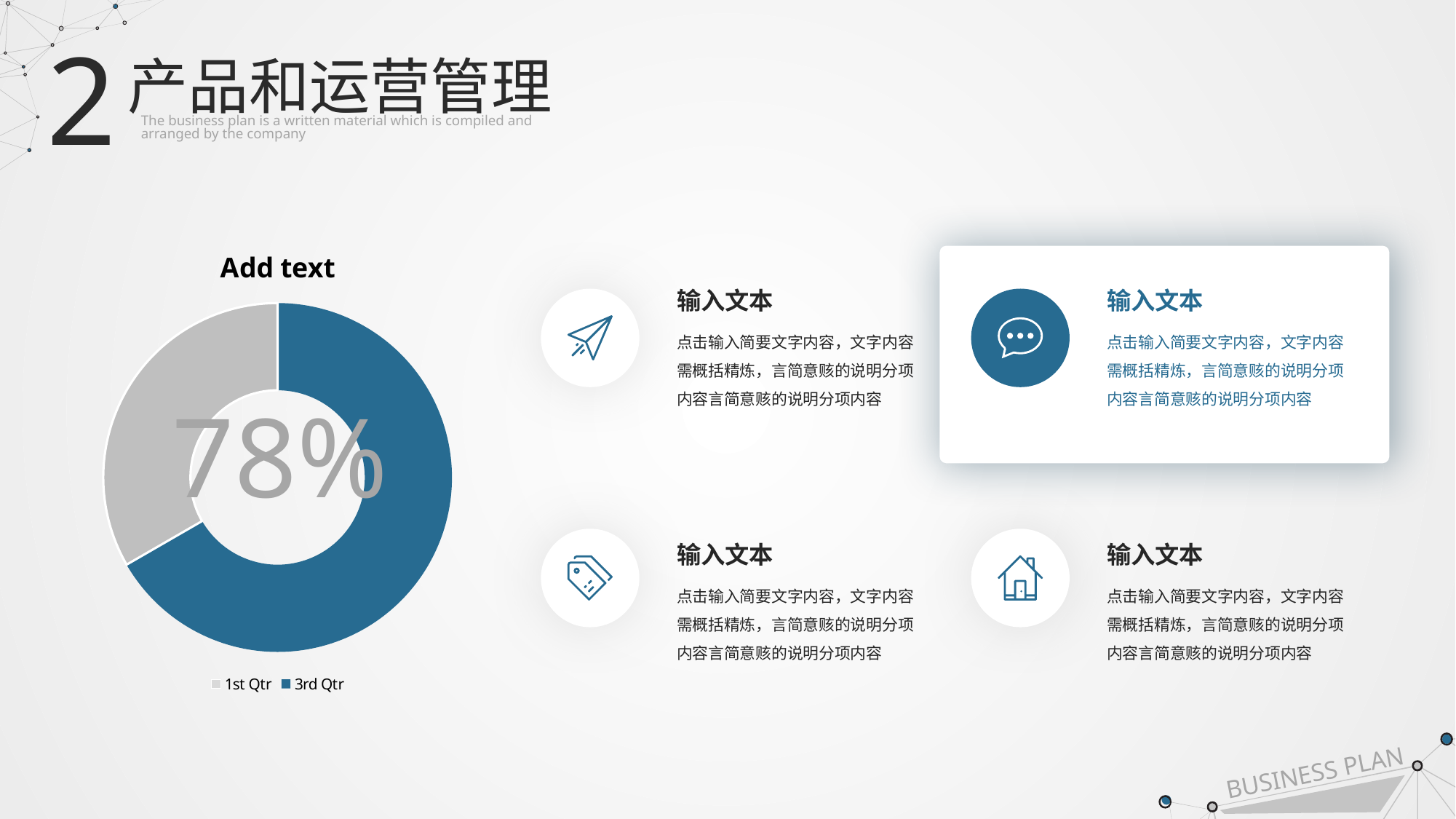
Which category has the largest slice in the chart? 3rd Qtr What is the title of the chart? Add text Which category has the smallest slice in the chart? 1st Qtr What kind of chart is shown on the slide? doughnut chart How many entries does the chart's legend list? 2 Which slice is larger, 1st Qtr or 3rd Qtr? 3rd Qtr What percentage is printed in the centre of the doughnut chart? 78% How many slices does the doughnut chart have? 2